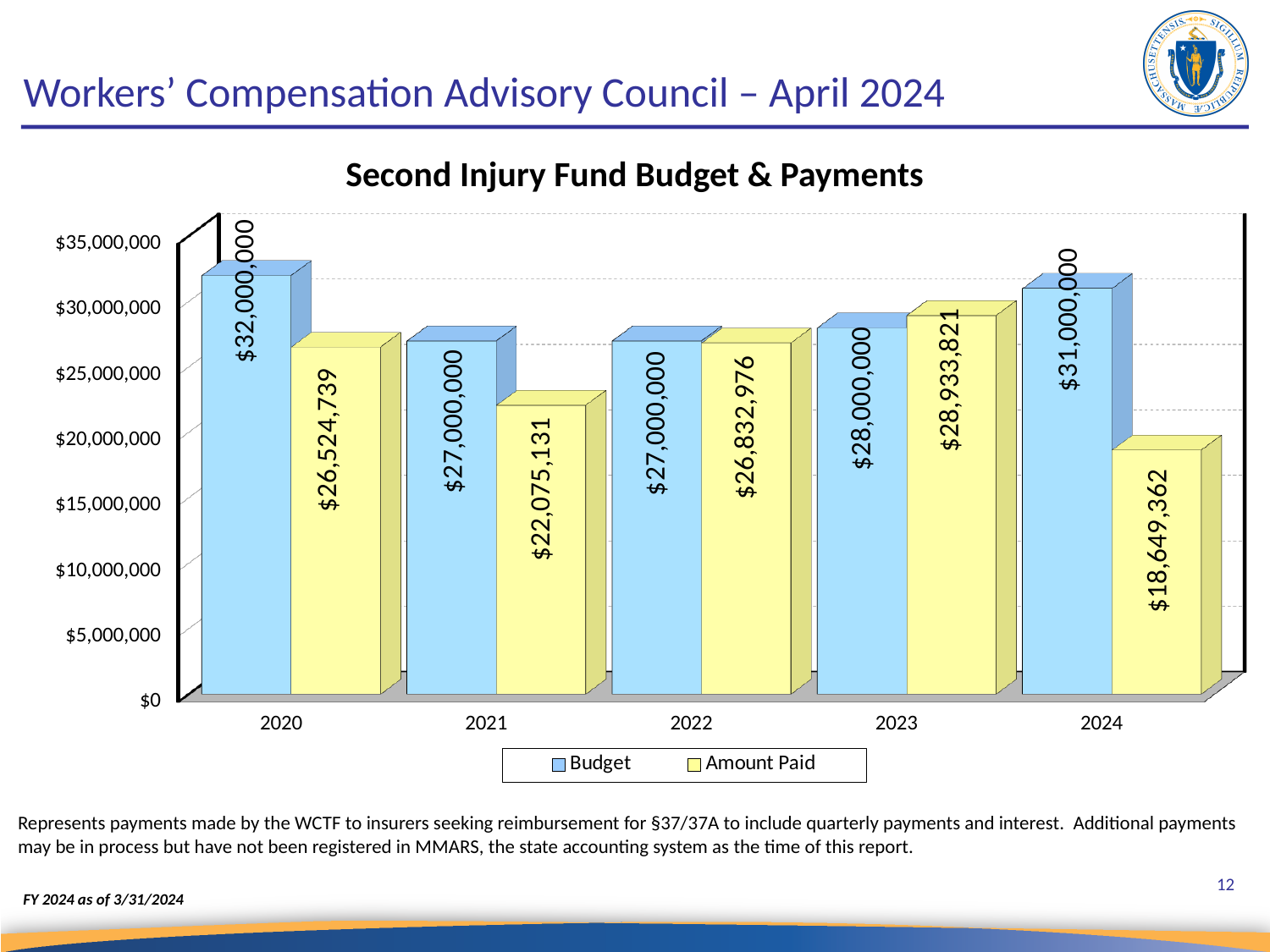
What is the Amount Paid for 2021? $22,075,131 How many years are shown on the x axis? 5 Which is larger in 2023, the Budget or the Amount Paid? Amount Paid What is the difference between the Budget and the Amount Paid in 2024? $12,350,638 What is the Budget value for 2020? $32,000,000 Which year has the lowest Amount Paid? 2024 What is the Budget value for 2023? $28,000,000 How many series does the legend list? 2 Which year has the highest Budget? 2020 What is the title of the chart? Second Injury Fund Budget & Payments What kind of chart is shown? Bar chart What is the Amount Paid for 2024? $18,649,362